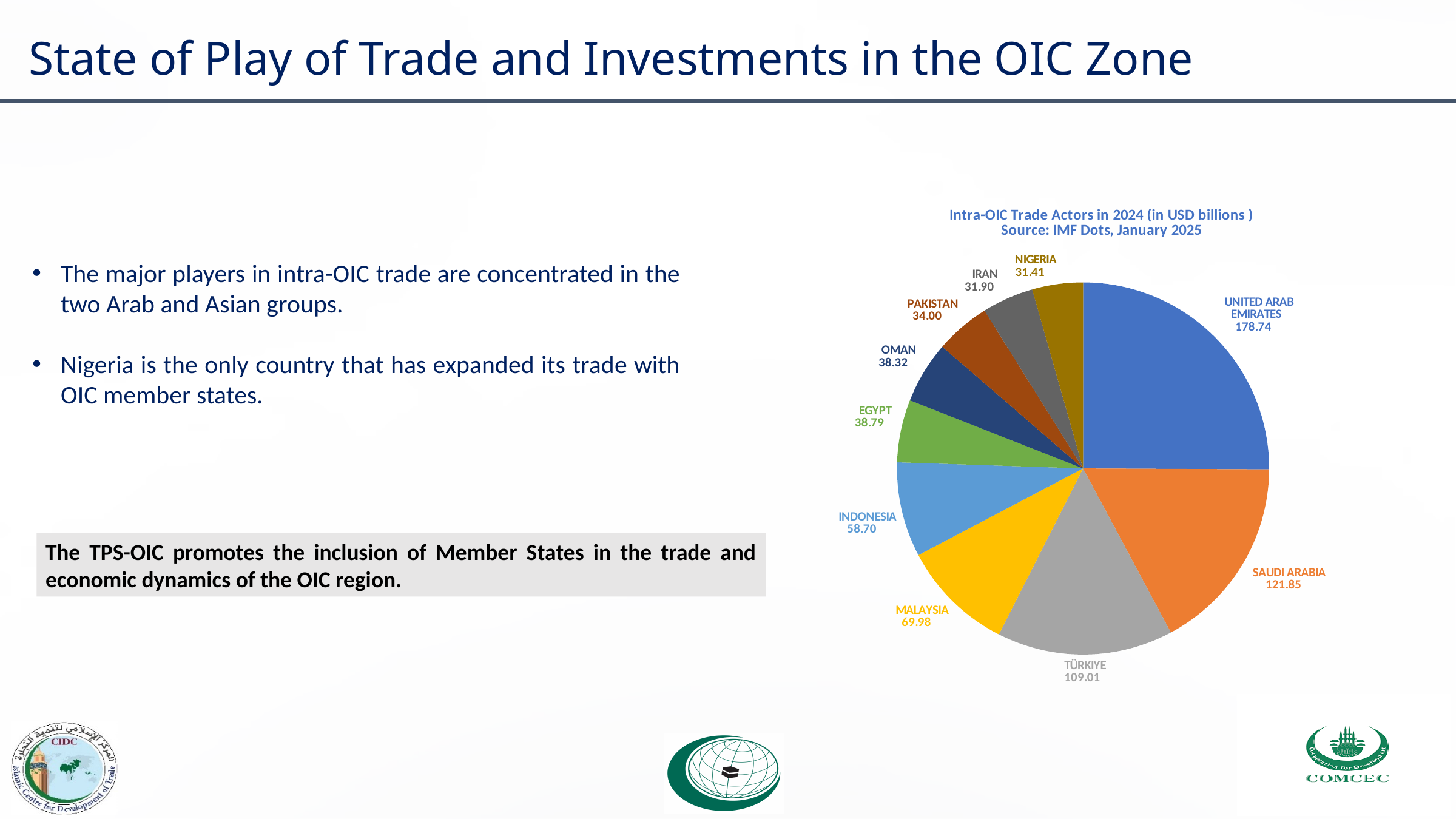
What is the difference between the values for Malaysia and Indonesia? 11.28 Which has a larger value, Iran or Nigeria? Iran Which country has the smallest slice in the pie chart? Nigeria What is the title of the pie chart? Intra-OIC Trade Actors in 2024 (in USD billions ) What is the value for Türkiye in the pie chart? 109.01 How many countries are shown in the pie chart? 10 What is the difference between the values for United Arab Emirates and Saudi Arabia? 56.89 Which country has the largest slice in the pie chart? United Arab Emirates Which has a larger value, Egypt or Oman? Egypt What is the value for United Arab Emirates in the Intra-OIC Trade Actors pie chart? 178.74 What is the value for Pakistan in the pie chart? 34.00 What type of chart is shown on the slide? Pie chart